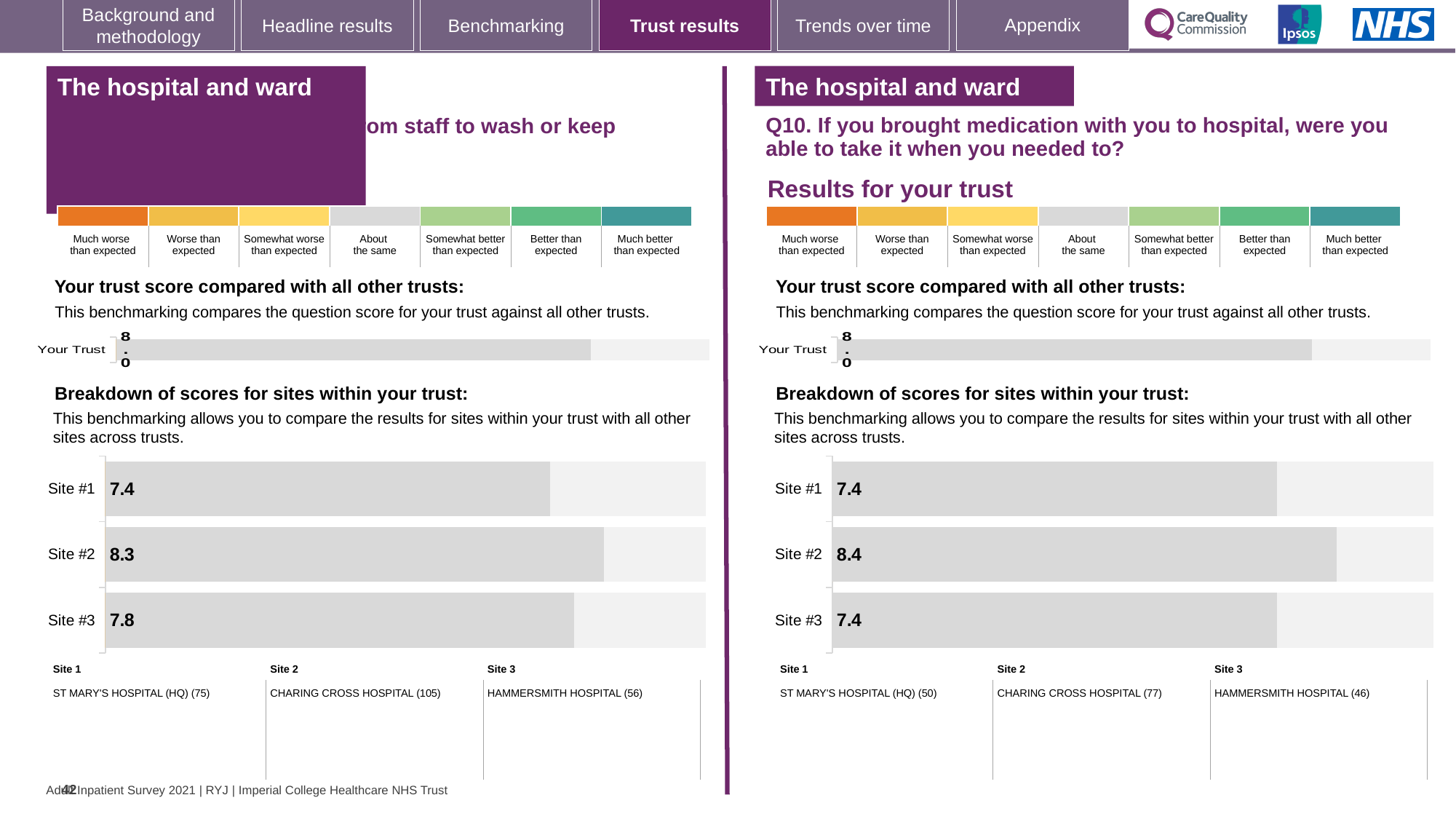
In the site breakdown chart on the left half of the slide, which site has the highest score? Site #2 What kind of chart is used for the breakdown of scores for sites on the right half of the slide (Q10)? Bar chart In the site breakdown chart on the right half of the slide (Q10), what is the score for Site #1? 7.4 In the site breakdown chart on the left half of the slide, what is the score for Site #3? 7.8 In the site breakdown chart on the right half of the slide (Q10), what is the score for Site #2? 8.4 In the site breakdown chart on the right half of the slide (Q10), which site has the highest score? Site #2 In the site breakdown chart on the left half of the slide, which site has the lowest score? Site #1 In the site breakdown chart on the left half of the slide, which is larger, the score for Site #3 or the score for Site #1? Site #3 How many sites are shown in the site breakdown chart on the right half of the slide (Q10)? 3 In the site breakdown chart on the left half of the slide, what is the score for Site #2? 8.3 In the site breakdown chart on the left half of the slide, what is the difference between the scores for Site #2 and Site #1? 0.9 In the site breakdown chart on the right half of the slide (Q10), what is the difference between the scores for Site #2 and Site #3? 1.0